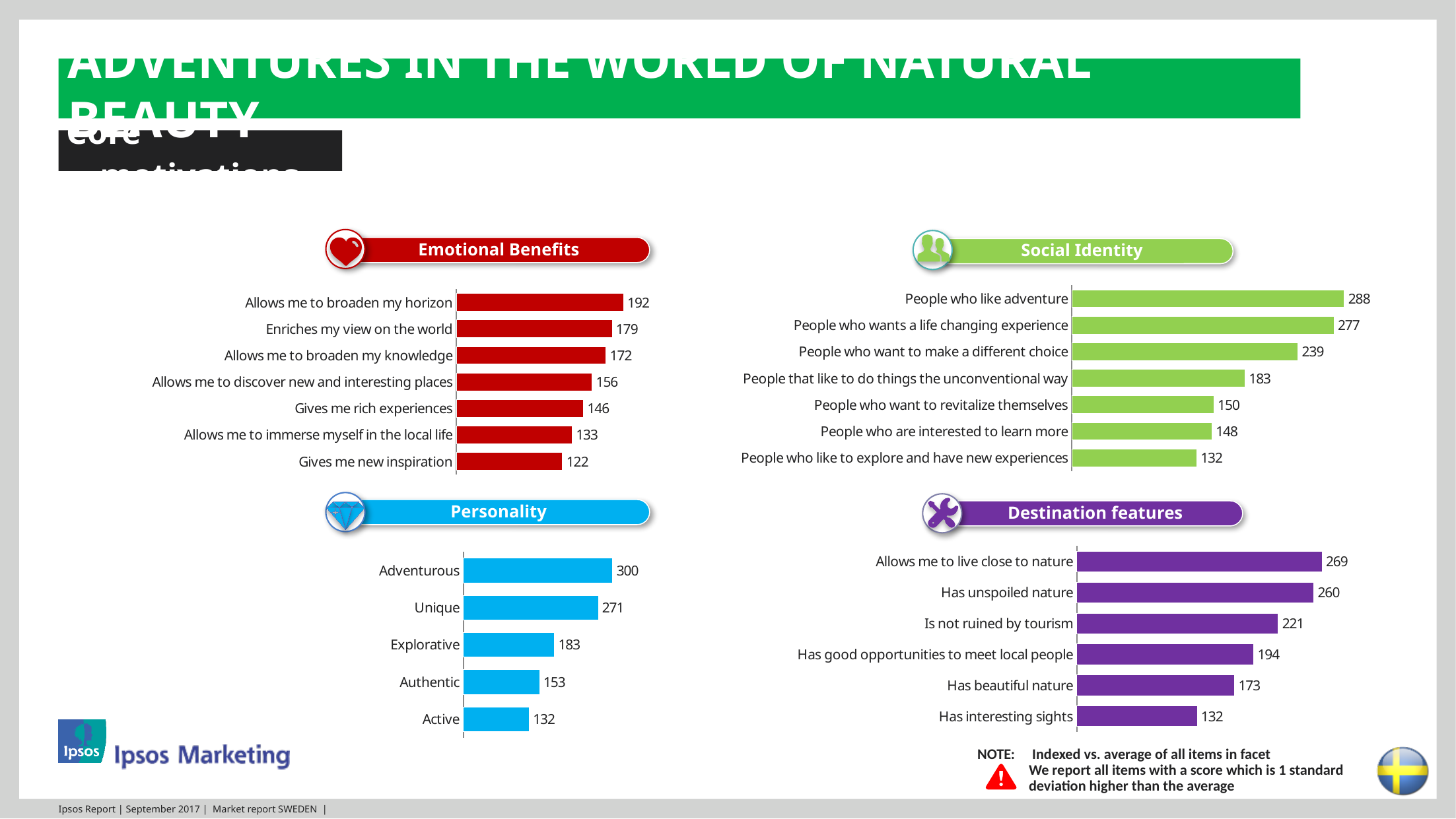
In the Personality chart, what is the value for "Explorative"? 183 In the Destination features chart, what is the difference between "Allows me to live close to nature" and "Has interesting sights"? 137 In the Destination features chart, what is the value for "Is not ruined by tourism"? 221 In the Destination features chart, which is larger: "Has beautiful nature" or "Has good opportunities to meet local people"? Has good opportunities to meet local people In the Social Identity chart, what is the value for "People who want to make a different choice"? 239 How many categories are shown in the Personality chart? 5 In the Social Identity chart, which category has the highest value? People who like adventure In the Emotional Benefits chart, what is the value for "Allows me to broaden my horizon"? 192 In the Social Identity chart, what is the difference between "People who like adventure" and "People who wants a life changing experience"? 11 What type of chart is the Social Identity chart? Bar chart How many categories are shown in the Emotional Benefits chart? 7 In the Emotional Benefits chart, which category has the lowest value? Gives me new inspiration